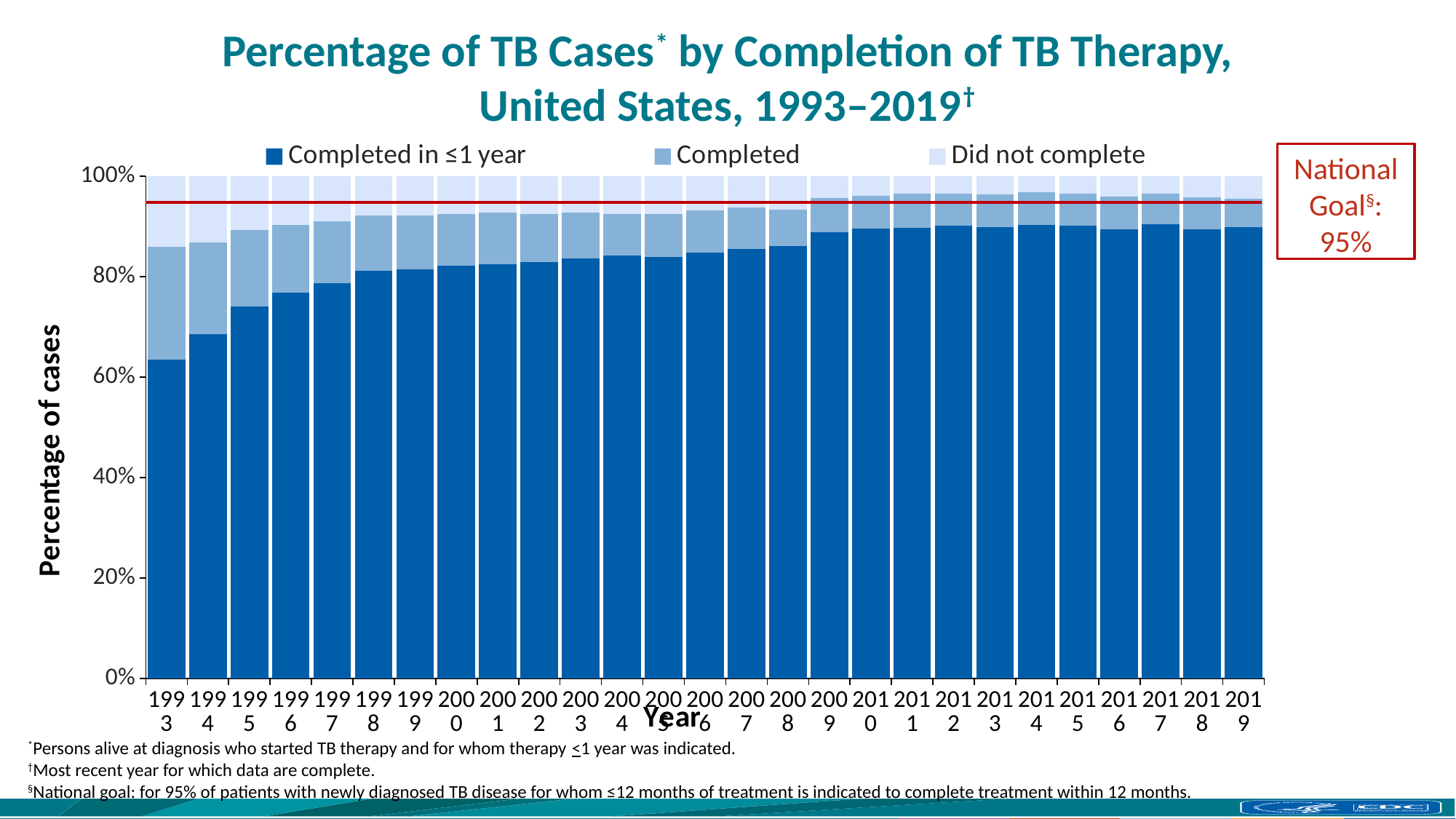
Is the value for 'Completed in ≤1 year' in 1993 greater or less than 80%? less Which year has the larger 'Did not complete' share, 1993 or 2019? 1993 Which year has the larger value for 'Completed in ≤1 year', 1993 or 2019? 2019 What is the total of the stacked bar for 1993? 100% What kind of chart is shown on the slide? Stacked bar chart Does the 'Completed in ≤1 year' share generally rise or fall from 1993 to 2019? Rise Is the value for 'Completed in ≤1 year' in 2019 greater or less than 80%? greater Is the value for 'Completed in ≤1 year' in 1995 greater or less than 80%? less Which year has the lowest value for 'Completed in ≤1 year'? 1993 How many years are plotted along the x axis? 27 What national goal percentage is marked by the red line on the chart? 95% How many series does the legend list? 3